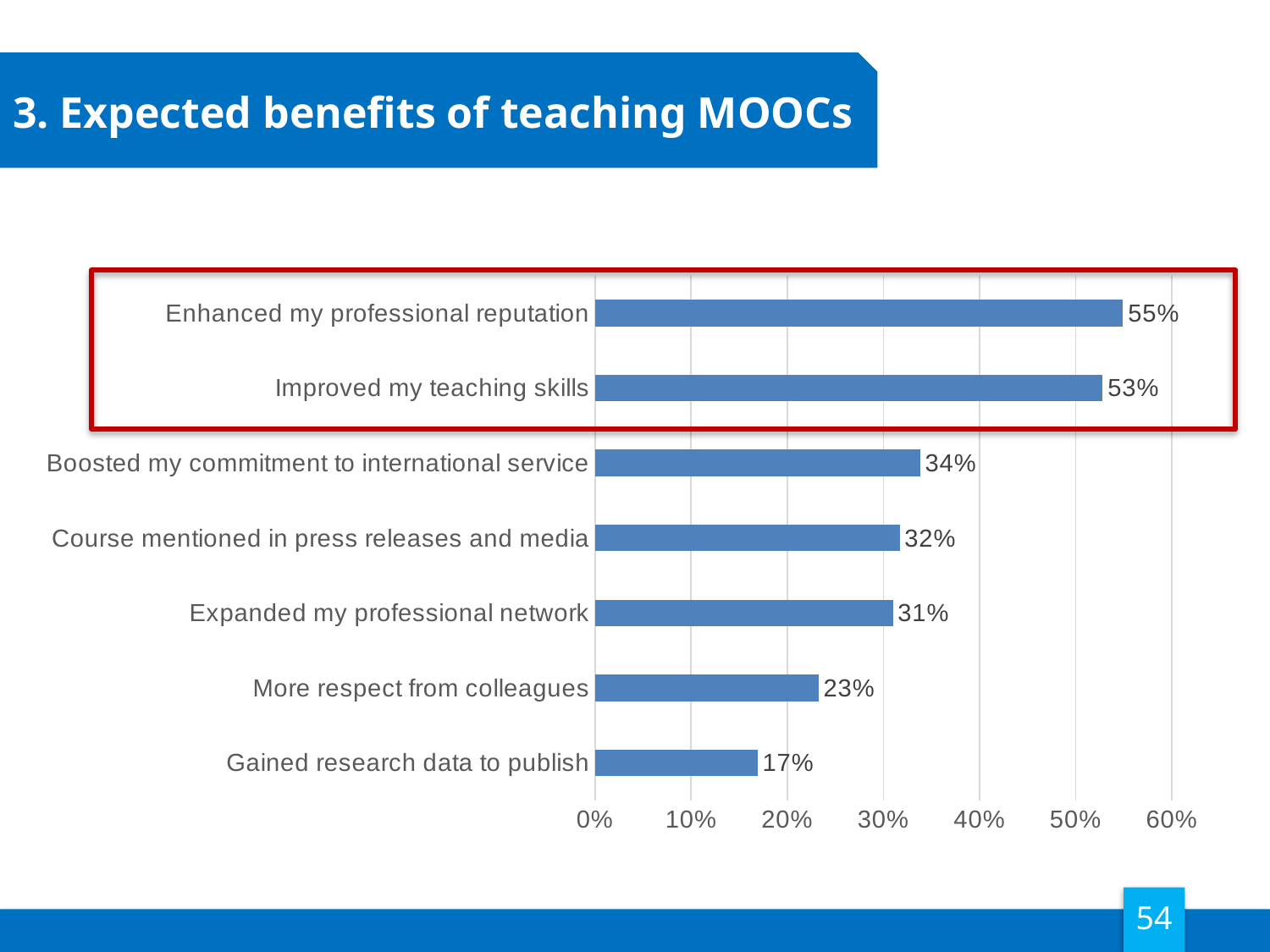
What is the difference between 'More respect from colleagues' and 'Gained research data to publish'? 6 percentage points What type of chart is shown on the slide? Bar chart What percentage of respondents expected that teaching MOOCs would enhance their professional reputation? 55% Which two categories are highlighted with a red box on the chart? Enhanced my professional reputation and Improved my teaching skills What is the value shown for 'Gained research data to publish'? 17% How many expected benefits are listed in the chart? 7 Which is larger: 'Course mentioned in press releases and media' or 'Expanded my professional network'? Course mentioned in press releases and media What is the difference in percentage points between 'Enhanced my professional reputation' and 'Improved my teaching skills'? 2 percentage points Which expected benefit has the highest percentage? Enhanced my professional reputation What is the value shown for 'Boosted my commitment to international service'? 34% Which expected benefit has the lowest percentage? Gained research data to publish Is the value for 'More respect from colleagues' greater or less than 30%? less